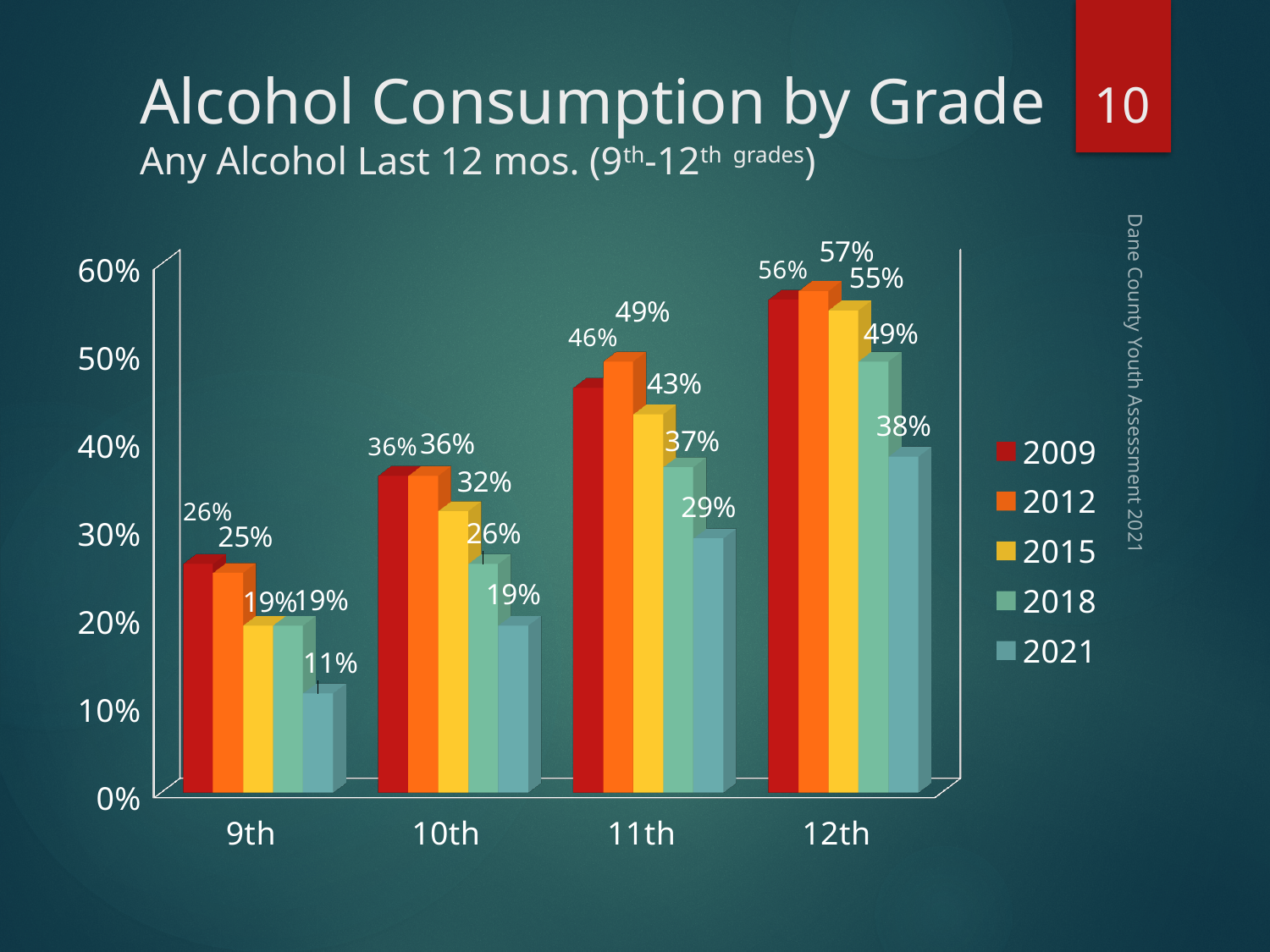
How many grade categories are shown on the x axis? 4 How many series does the legend list? 5 Which is larger: the 2015 value for 10th grade or the 2018 value for 11th grade? 2018 value for 11th grade Do the 2021 values rise or fall from 9th grade to 12th grade? Rise What is the value for 2012 in the 11th grade group? 49% What is the value for 2015 in the 12th grade group? 55% What is the value for 2018 in the 10th grade group? 26% What is the difference between the 2009 and 2021 values for 12th grade? 18% Which grade has the highest value for 2021? 12th What is the value for 2021 in the 9th grade group? 11% Which year has the lowest value in the 11th grade group? 2021 What kind of chart is shown on the slide? Bar chart